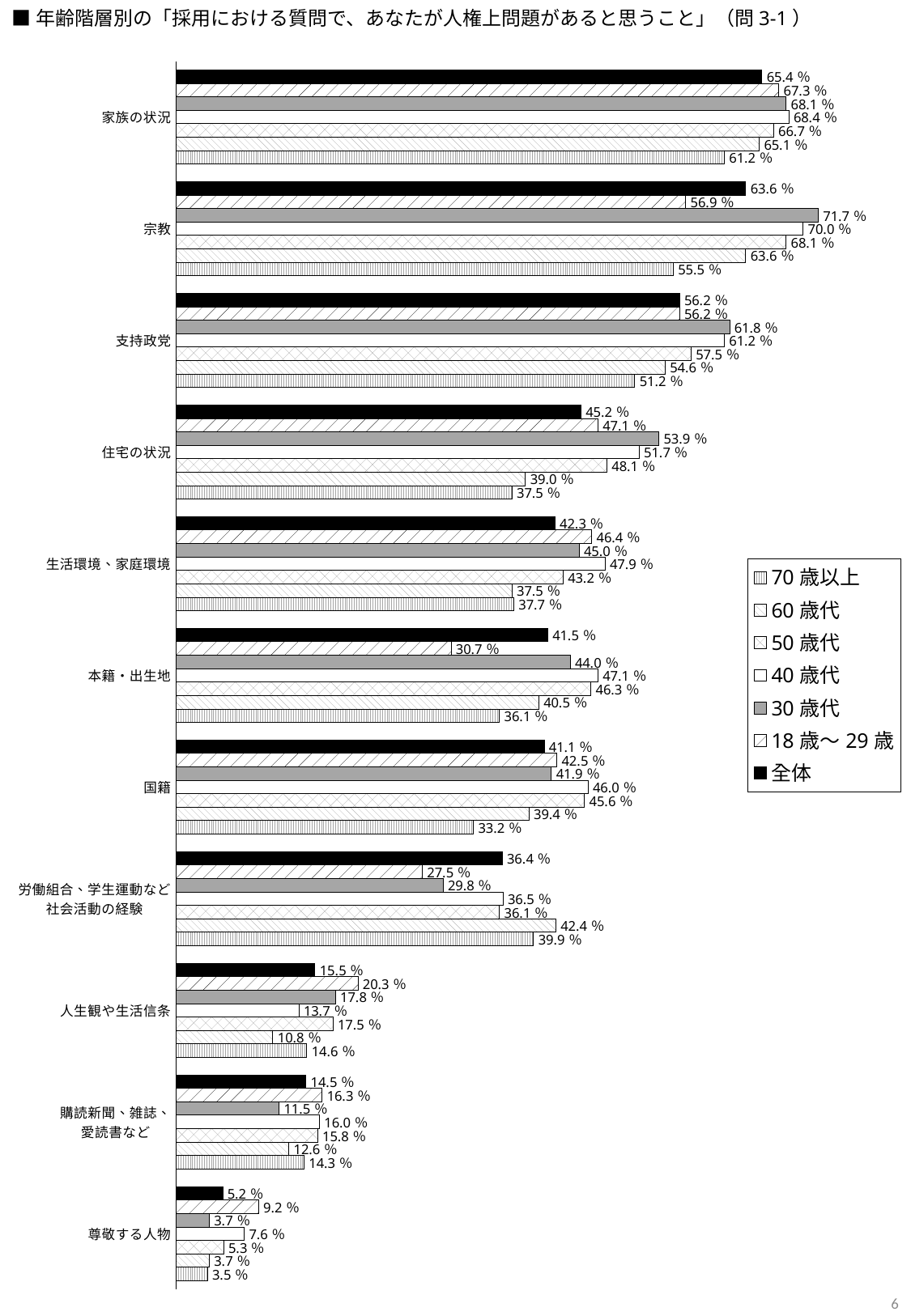
Which age group has the highest value for 宗教? 30歳代 Which is larger for 労働組合、学生運動など社会活動の経験: the 60歳代 value or the 18歳〜29歳 value? 60歳代 What kind of chart is shown on the slide? Bar chart How many categories are shown on the chart? 11 What is the difference between the 30歳代 and 70歳以上 values for 宗教? 16.2 % How many series does the legend list? 7 What is the difference between the 全体 values for 家族の状況 and 尊敬する人物? 60.2 % What is the 70歳以上 value for 住宅の状況? 37.5 % What is the 全体 value for 家族の状況? 65.4 % Which category has the lowest 全体 value? 尊敬する人物 What is the 18歳〜29歳 value for 本籍・出生地? 30.7 % What is the 30歳代 value for 宗教? 71.7 %